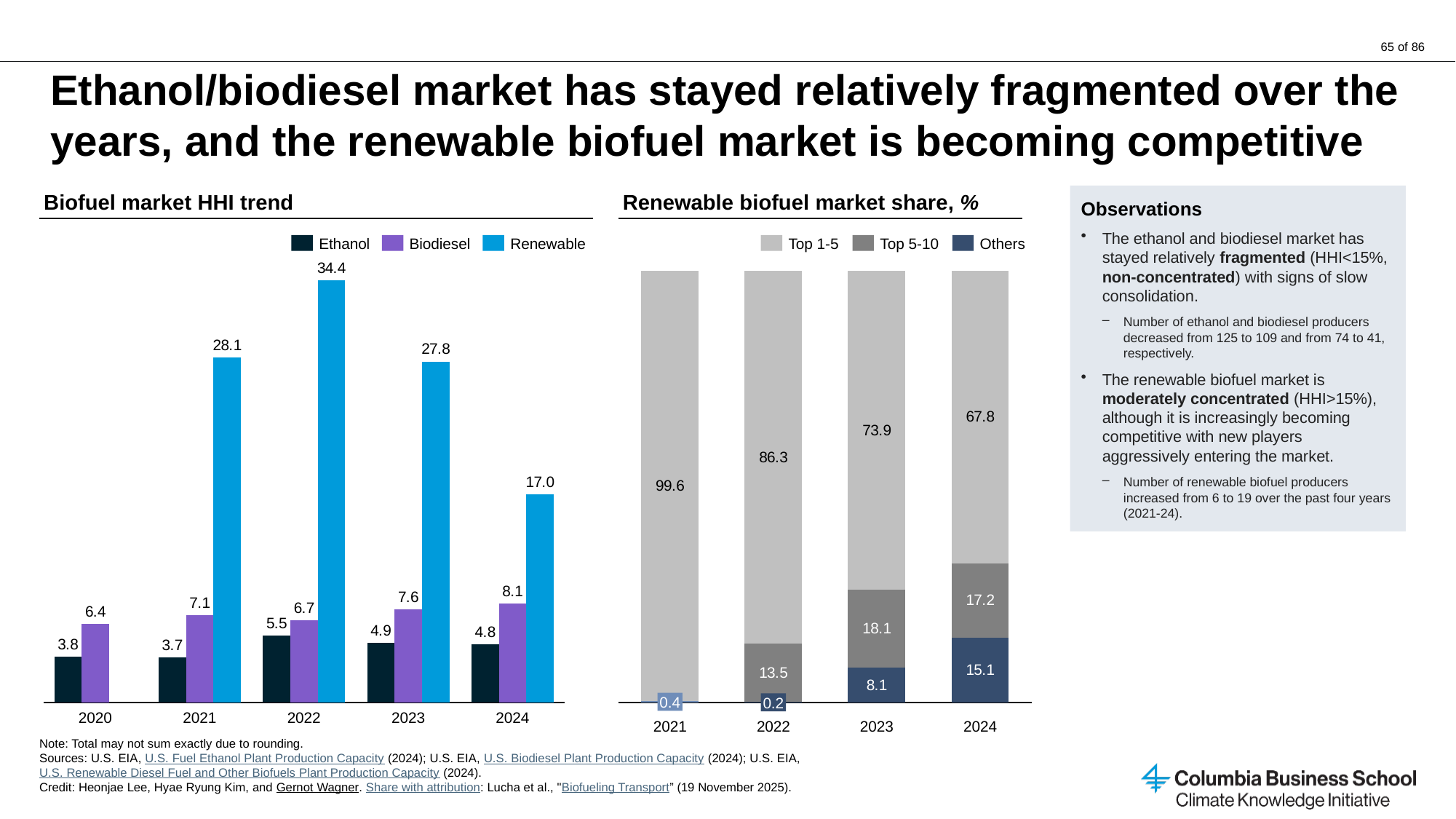
How many years are shown on the x axis of the 'Renewable biofuel market share, %' chart? 4 In the 'Renewable biofuel market share, %' chart, does the Top 1-5 share rise or fall from 2021 to 2024? fall How many series does the legend of the 'Biofuel market HHI trend' chart list? 3 In the 'Biofuel market HHI trend' chart, what is the Renewable value for 2022? 34.4 In the 'Biofuel market HHI trend' chart, which year has the highest Renewable value? 2022 What kind of chart is the 'Renewable biofuel market share, %' chart? stacked bar chart In the 'Renewable biofuel market share, %' chart, what is the Others value for 2024? 15.1 In the 'Biofuel market HHI trend' chart, what is the difference between the Renewable values for 2023 and 2024? 10.8 In the 'Biofuel market HHI trend' chart, what is the Ethanol value for 2020? 3.8 In the 'Biofuel market HHI trend' chart, which year has the lowest Ethanol value? 2021 In the 'Renewable biofuel market share, %' chart, what is the Top 5-10 value for 2023? 18.1 In the 'Biofuel market HHI trend' chart, is the Biodiesel value for 2024 larger or smaller than the Biodiesel value for 2021? larger